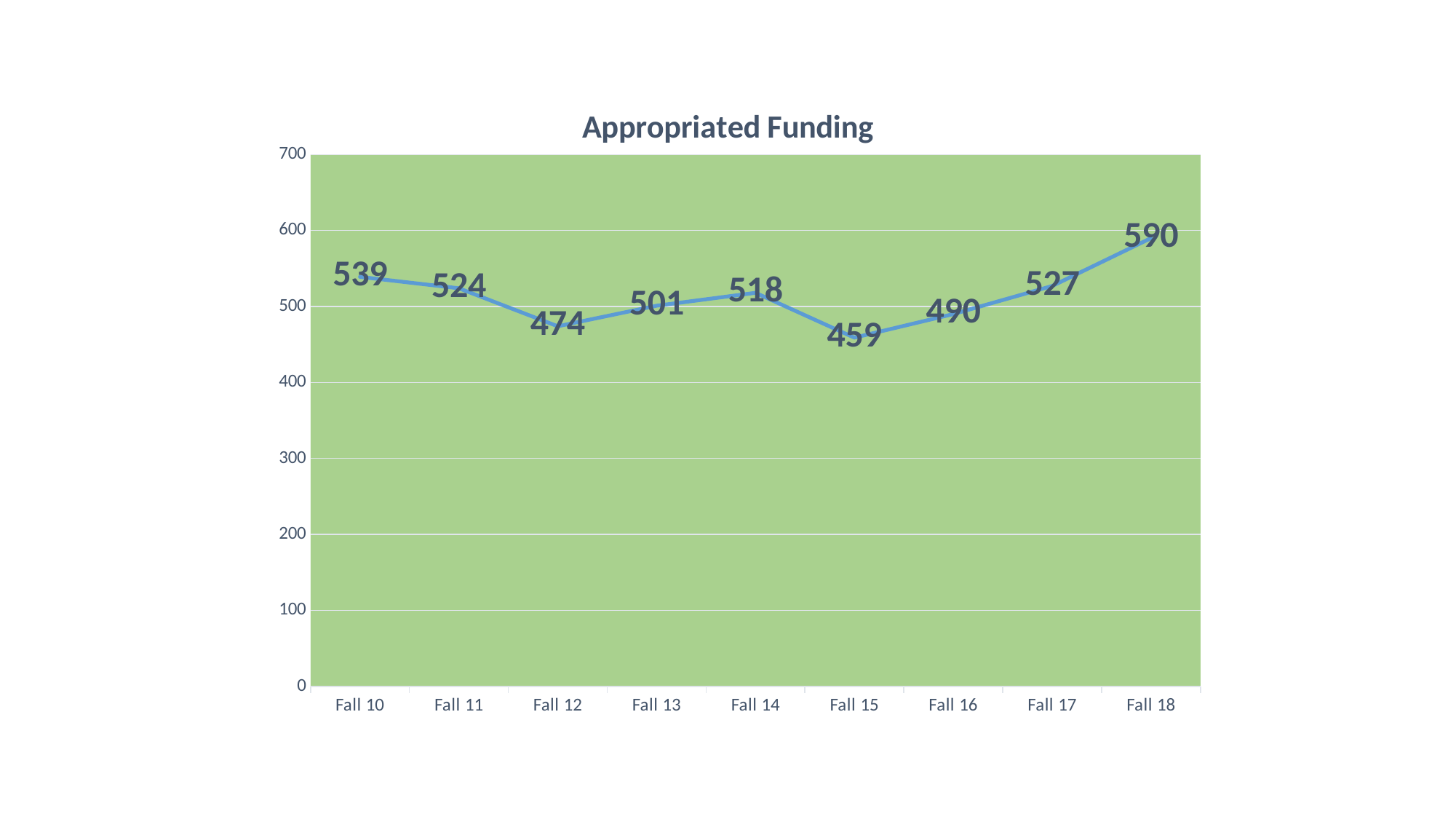
What is the difference between the values for Fall 10 and Fall 11? 15 Which period has the highest value? Fall 18 Which is larger, the value for Fall 13 or the value for Fall 16? Fall 13 What is the title of the chart? Appropriated Funding How many periods are plotted on the x axis? 9 Which period has the lowest value? Fall 15 What is the value for Fall 18? 590 Is the value for Fall 14 greater or less than 500? greater What is the value for Fall 12? 474 What is the difference between the values for Fall 18 and Fall 15? 131 What kind of chart is shown? line chart What is the value for Fall 15? 459